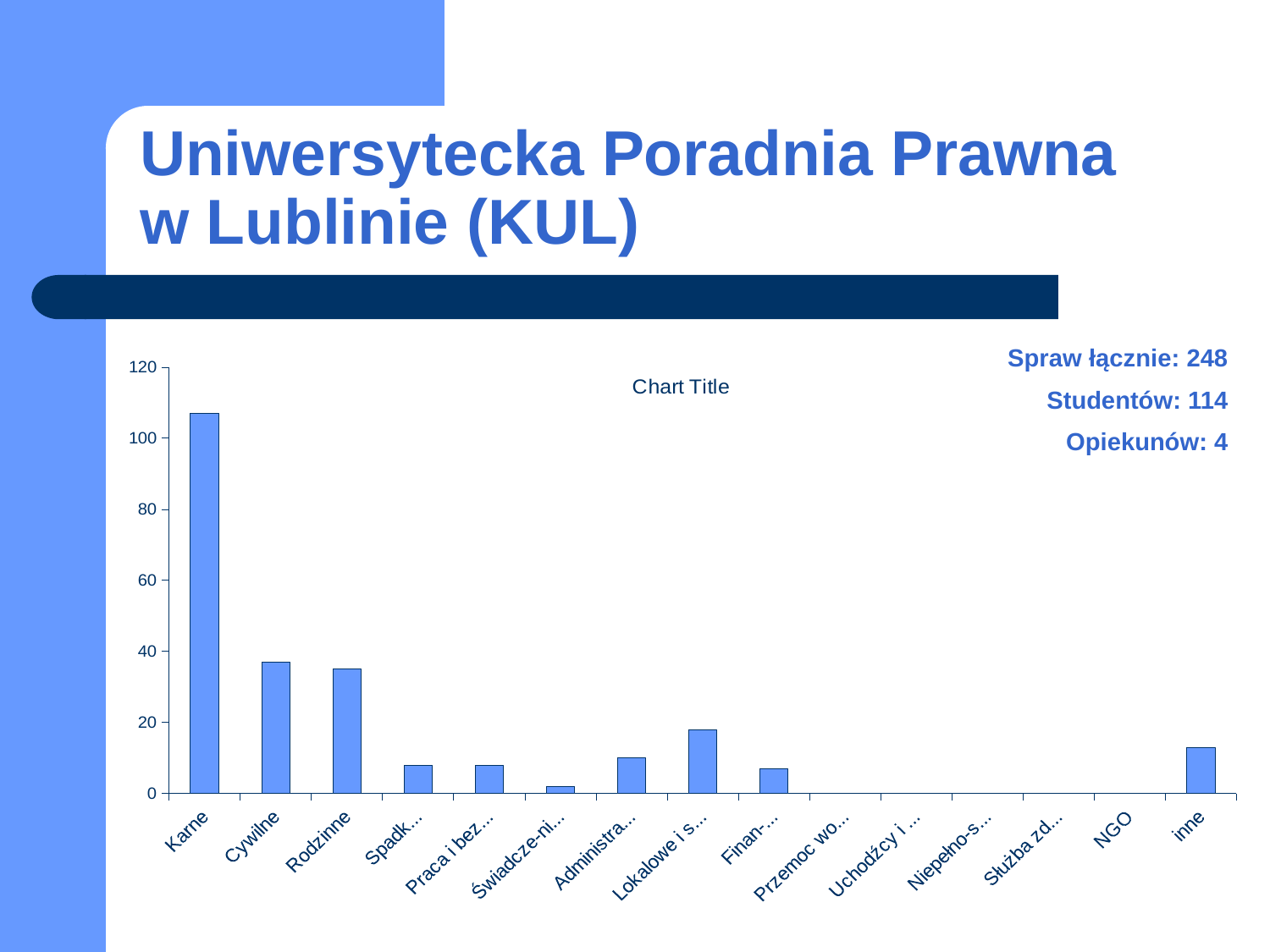
Is the value for Rodzinne greater or less than 20? greater Which is larger, the value for Karne or the value for Cywilne? Karne Which category has the highest value in the chart? Karne Which is larger, the value for Administra... or the value for Świadcze-ni...? Administra... Is the value for Lokalowe i s... greater or less than 20? less Is the value for Cywilne greater or less than 40? less What is the title displayed on the chart? Chart Title What kind of chart is shown on the slide? bar chart How many categories are shown on the x axis of the chart? 15 Which is larger, the value for Lokalowe i s... or the value for inne? Lokalowe i s...